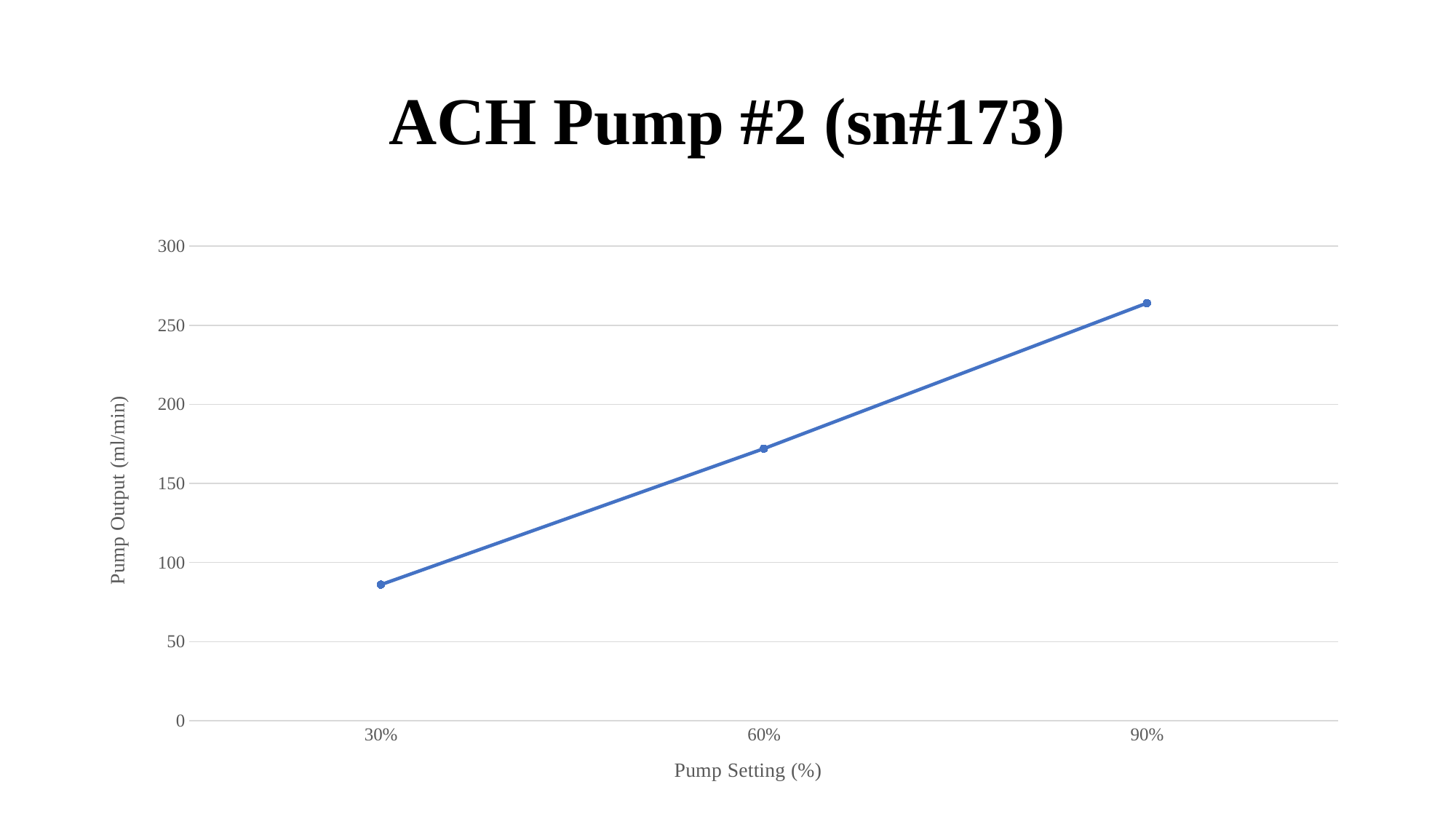
Is the pump output at the 90% setting greater or less than 250? greater Which has a larger pump output, the 60% setting or the 30% setting? 60% What is the title of the chart? ACH Pump #2 (sn#173) Which pump setting has the lowest pump output? 30% What kind of chart is shown on the slide? line chart What is the label of the y axis? Pump Output (ml/min) Is the pump output at the 90% setting greater or less than 300? less Does the pump output rise or fall as the pump setting increases from 30% to 90%? rise Is the pump output at the 30% setting greater or less than 100? less Which pump setting has the highest pump output? 90% How many data points are plotted on the chart? 3